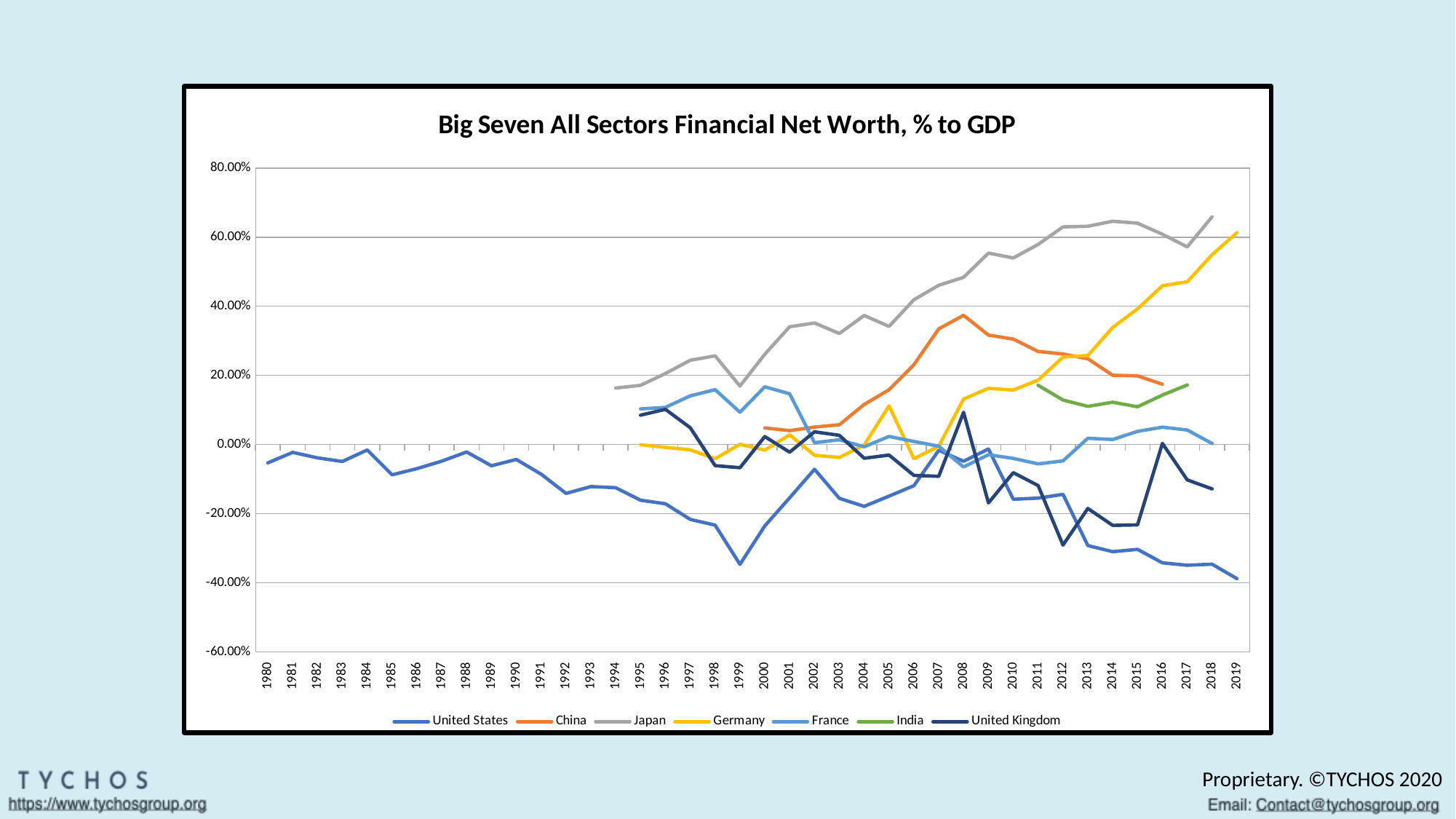
Is the value for United States in 2019 greater or less than -20.00%? less In 2016, which is larger: the value for China or the value for Germany? Germany Is the value for Japan in 2018 greater or less than 60.00%? greater Which series has the lowest value in 2016? United States Which series has the highest value in 2018? Japan How many series does the legend list? 7 Is the value for China in 2008 greater or less than 20.00%? greater Does the value for United States rise or fall from 2008 to 2019? fall What kind of chart is shown on the slide? line chart What is the title of the chart? Big Seven All Sectors Financial Net Worth, % to GDP Does the value for Germany rise or fall from 2011 to 2019? rise How many years are shown on the x axis? 40